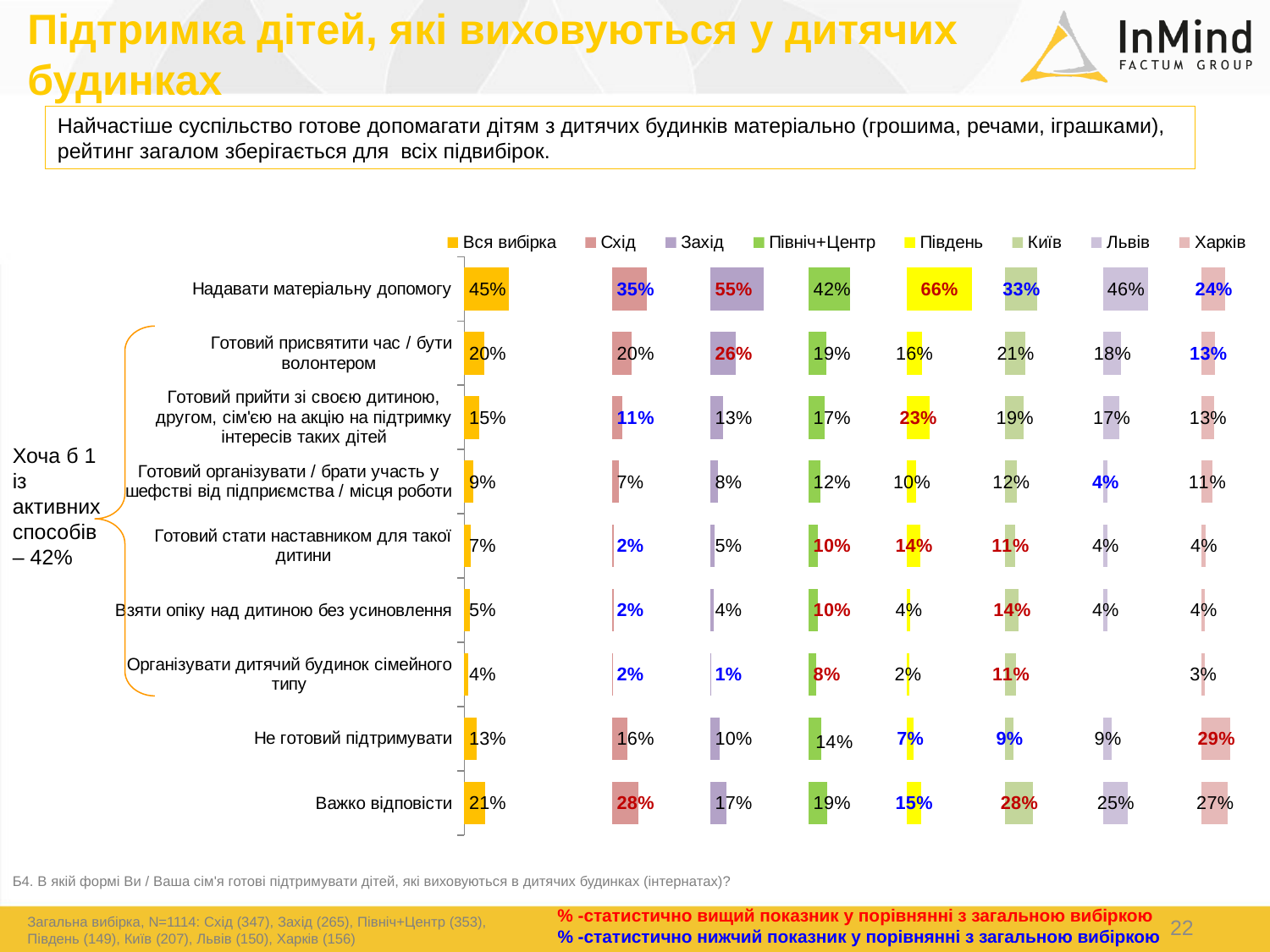
What is the difference between the "Вся вибірка" values for "Надавати матеріальну допомогу" and "Важко відповісти"? 24% Which colour represents the "Південь" series in the legend? Yellow Which region series has the highest value for "Надавати матеріальну допомогу"? Південь How many categories are shown on the chart? 9 Which region series has the lowest value for "Надавати матеріальну допомогу"? Харків What is the difference between the "Захід" and "Схід" values for "Надавати матеріальну допомогу"? 20% For "Важко відповісти", which is larger: the "Схід" value or the "Захід" value? Схід What is the value for "Надавати матеріальну допомогу" in the "Вся вибірка" series? 45% What is the value for "Не готовий підтримувати" in the "Харків" series? 29% How many series does the legend list? 8 What kind of chart is shown on the slide? Bar chart What is the value for "Готовий стати наставником для такої дитини" in the "Південь" series? 14%